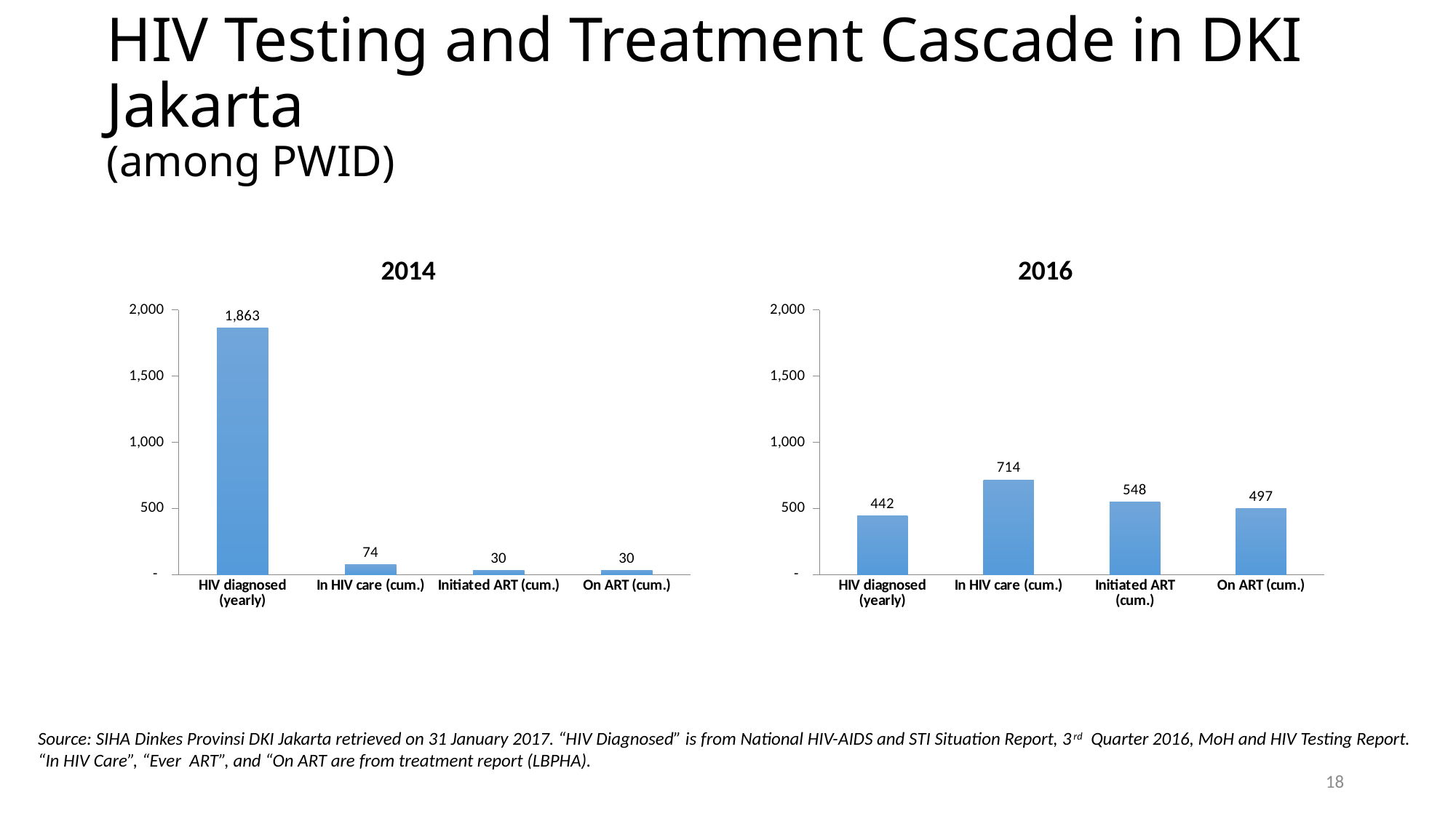
In the 2016 chart, what is the value for In HIV care (cum.)? 714 In the 2016 chart, what is the difference between In HIV care (cum.) and Initiated ART (cum.)? 166 How many categories are shown in the 2014 chart? 4 In the 2014 chart, what is the value for HIV diagnosed (yearly)? 1,863 In the 2016 chart, which category has the lowest value? HIV diagnosed (yearly) In the 2016 chart, which is larger: Initiated ART (cum.) or On ART (cum.)? Initiated ART (cum.) In the 2014 chart, do the values rise or fall from left to right along the x axis? fall In the 2016 chart, what is the value for On ART (cum.)? 497 In the 2016 chart, is the value for HIV diagnosed (yearly) greater or less than 500? less In the 2014 chart, which category has the highest value? HIV diagnosed (yearly) What kind of chart is the 2016 chart? bar chart In the 2014 chart, what is the difference between HIV diagnosed (yearly) and In HIV care (cum.)? 1,789